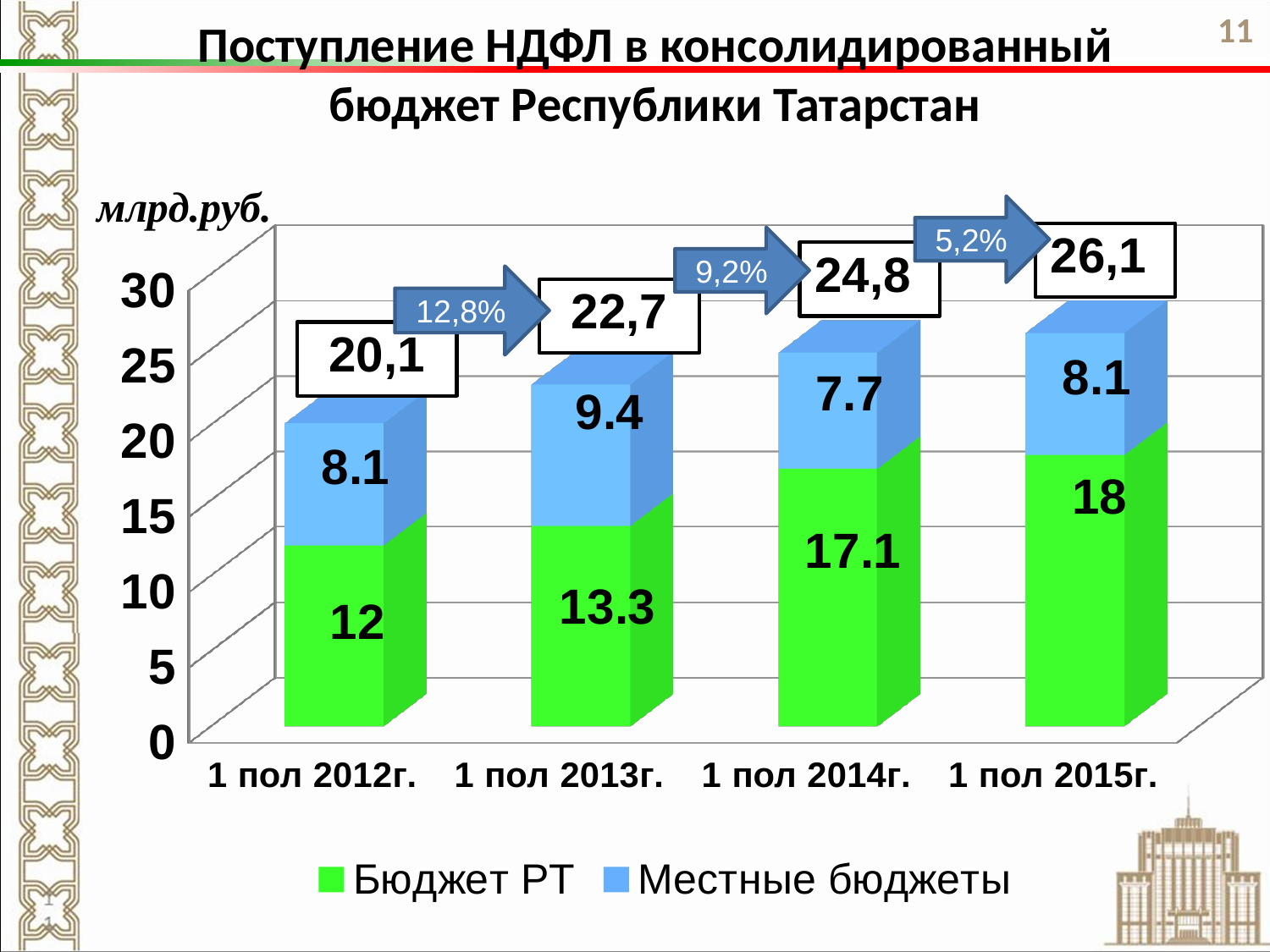
How many periods are shown on the x axis? 4 Which period has the highest value for Бюджет РТ? 1 пол 2015г. What percentage growth is shown by the arrow between 1 пол 2013г. and 1 пол 2014г.? 9,2% What is the value for Местные бюджеты in 1 пол 2013г.? 9.4 How many series does the legend list? 2 What is the difference between the Бюджет РТ values for 1 пол 2015г. and 1 пол 2012г.? 6 Which is larger: Местные бюджеты in 1 пол 2013г. or in 1 пол 2015г.? 1 пол 2013г. What is the total shown above the bar for 1 пол 2015г.? 26,1 What is the value for Бюджет РТ in 1 пол 2014г.? 17.1 What is the total shown above the bar for 1 пол 2012г.? 20,1 What kind of chart is shown on the slide? Stacked bar chart Which period has the lowest value for Местные бюджеты? 1 пол 2014г.